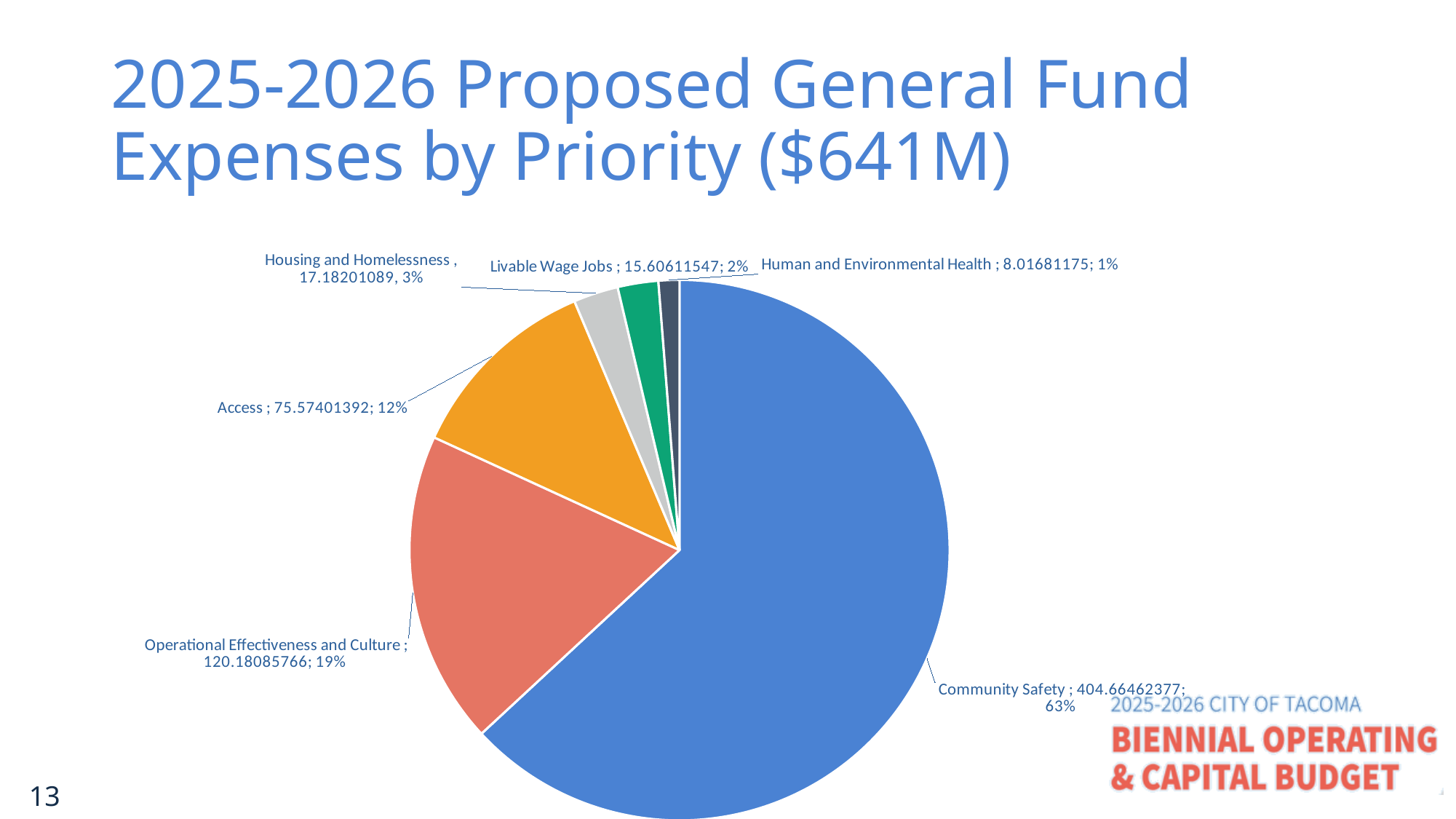
Which is larger, Operational Effectiveness and Culture or Access? Operational Effectiveness and Culture What share of the pie does Community Safety represent? 63% What type of chart is shown on the slide? Pie chart Which category has the smallest slice of the pie? Human and Environmental Health What share of the pie does Access represent? 12% How many categories (slices) does the pie chart show? 6 What is the title of the chart on the slide? 2025-2026 Proposed General Fund Expenses by Priority ($641M) Which category has the largest slice of the pie? Community Safety What is the value shown for Operational Effectiveness and Culture? 120.18085766 What is the difference between the values for Operational Effectiveness and Culture and Access? 44.60684374 What is the value shown for Community Safety? 404.66462377 What is the value shown for Access? 75.57401392